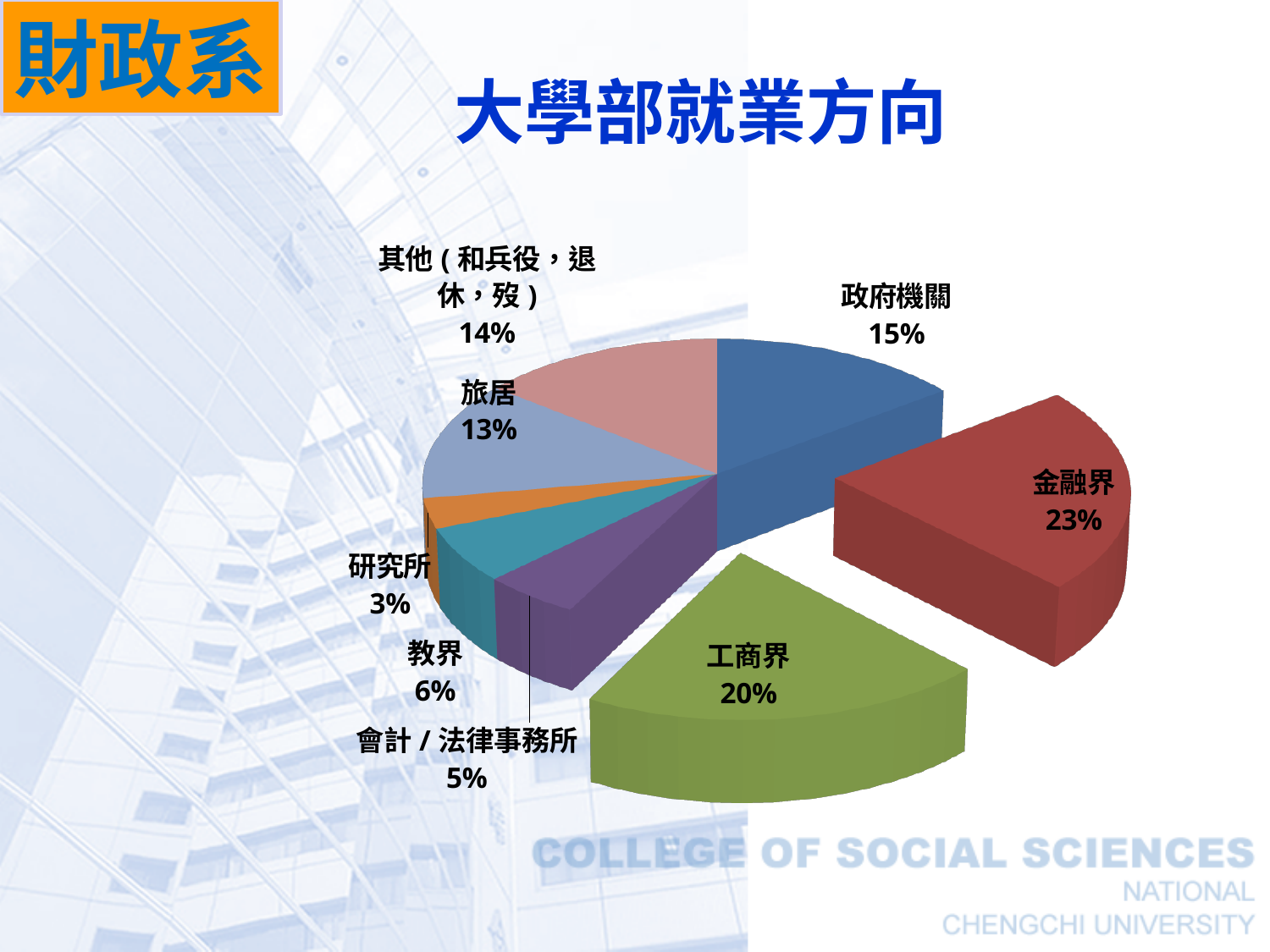
Which category has the smallest slice of the pie? 研究所 What kind of chart is shown on the slide? pie chart What share of the pie does 金融界 account for? 23% What percentage is labelled for 工商界? 20% Which category has the largest slice of the pie? 金融界 What is the value shown for 研究所? 3% How many slices does the pie chart have? 8 What is the difference in percentage points between 金融界 and 工商界? 3 What is the value shown for 政府機關? 15% What is the title of the chart on the slide? 大學部就業方向 Which is larger, the share for 教界 or the share for 會計／法律事務所? 教界 What percentage is shown for 旅居? 13%